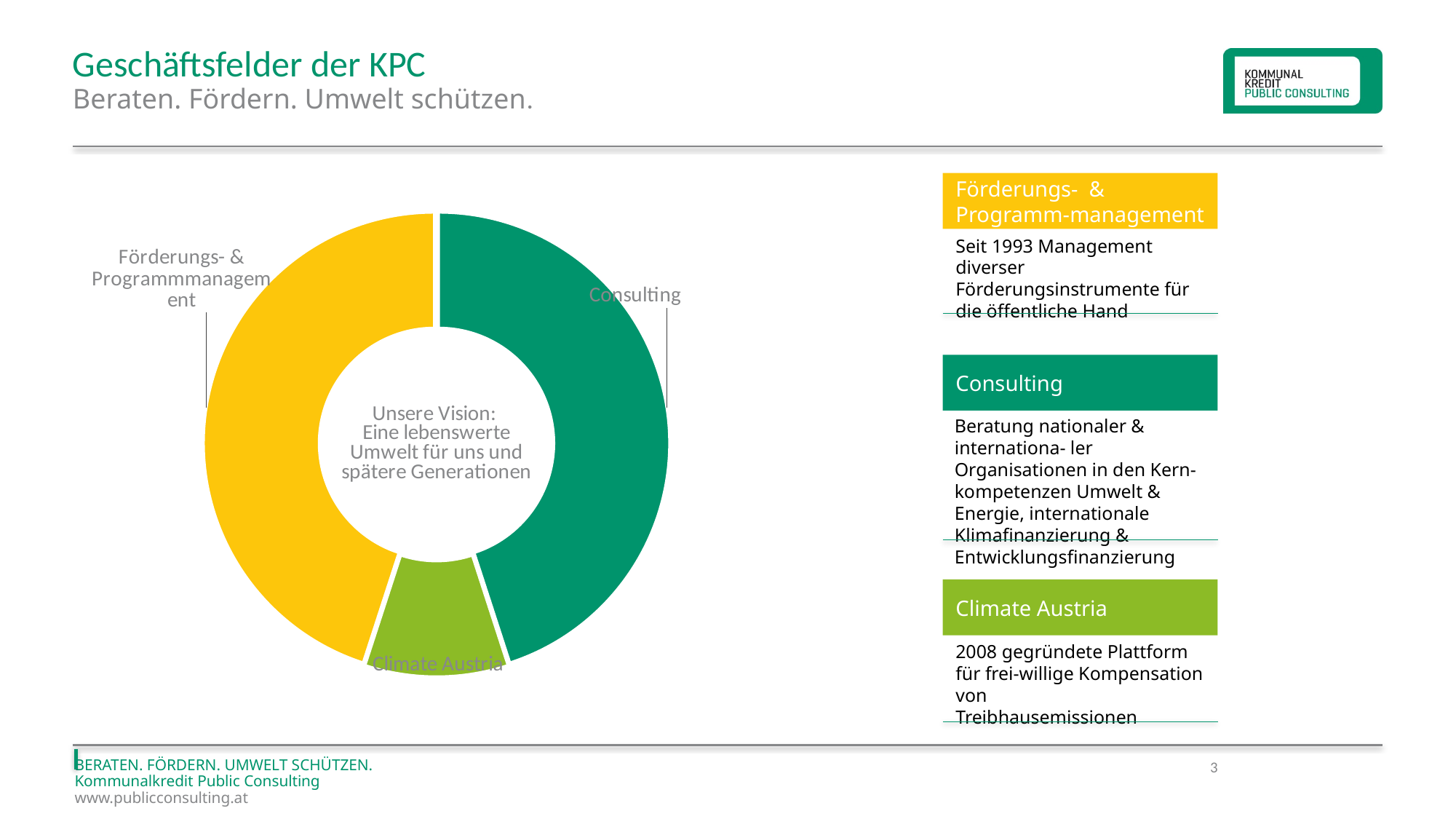
Which segment is larger, Förderungs- & Programmmanagement or Climate Austria? Förderungs- & Programmmanagement What colour is the Consulting segment of the doughnut chart? Dark green How many segments does the doughnut chart have? 3 What kind of chart is shown on the slide? Doughnut (pie) chart Which segment of the doughnut chart is the smallest? Climate Austria What text is shown in the centre of the doughnut chart? Unsere Vision: Eine lebenswerte Umwelt für uns und spätere Generationen Which segment is larger, Consulting or Climate Austria? Consulting